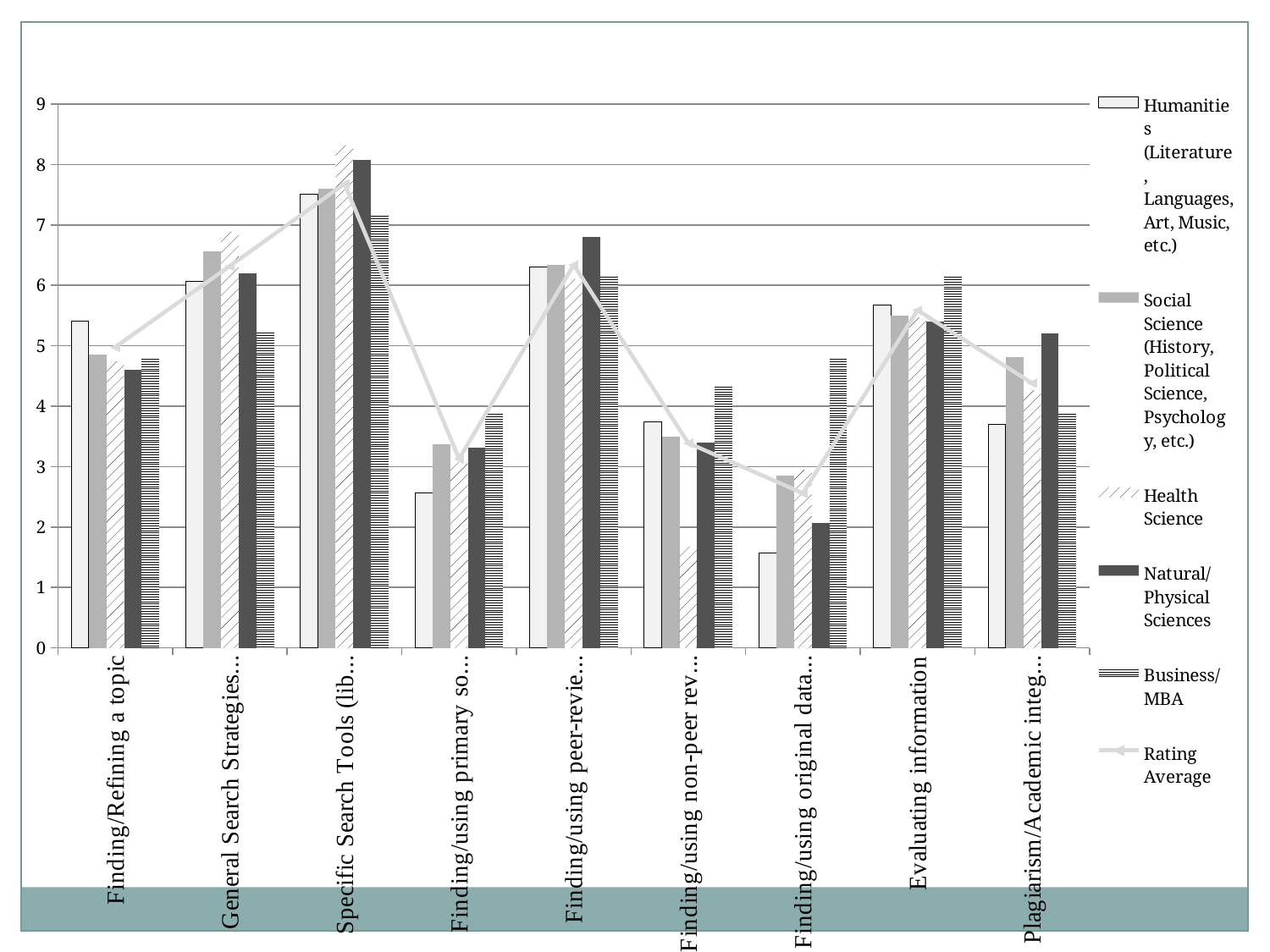
Is the Humanities value for Finding/Refining a topic greater or less than 5? greater Is the Natural/Physical Sciences value for Specific Search Tools greater or less than 7? greater How many series does the legend list? 6 For which category is the Natural/Physical Sciences value highest? Specific Search Tools How many categories are shown along the x axis? 9 For Evaluating information, which is larger: the Business/MBA value or the Natural/Physical Sciences value? Business/MBA Is the Social Science value for General Search Strategies greater or less than 6? greater What kind of chart is shown on the slide? bar chart (with a line for Rating Average) Does the Rating Average line rise or fall from Finding/using peer-reviewed to Finding/using original data? fall For which category is the Humanities value lowest? Finding/using original data For Finding/Refining a topic, which is larger: the Humanities value or the Social Science value? Humanities